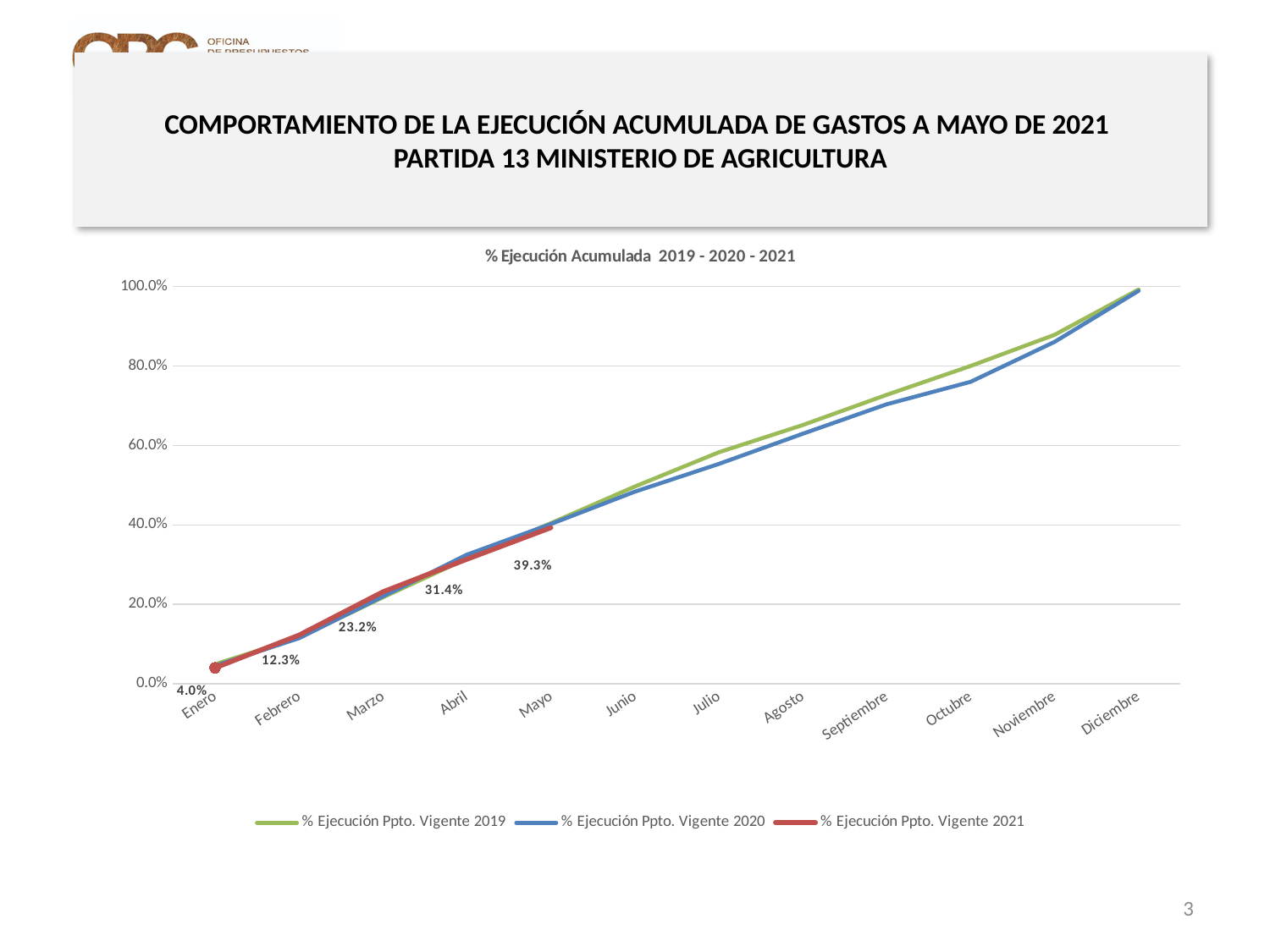
What is the title of the chart? % Ejecución Acumulada 2019 - 2020 - 2021 What is the value for Marzo in the % Ejecución Ppto. Vigente 2021 series? 23.2% Is the value for Octubre in the % Ejecución Ppto. Vigente 2020 series greater or less than 80.0%? less What is the value for Enero in the % Ejecución Ppto. Vigente 2021 series? 4.0% Do the values rise or fall from Enero to Diciembre in the % Ejecución Ppto. Vigente 2020 series? rise What is the difference between the Mayo and Abril values in the % Ejecución Ppto. Vigente 2021 series? 7.9% How many series does the legend list? 3 Which month has the highest value in the % Ejecución Ppto. Vigente 2021 series? Mayo What kind of chart is shown on the slide? line chart What is the value for Mayo in the % Ejecución Ppto. Vigente 2021 series? 39.3% Which month has the lowest value in the % Ejecución Ppto. Vigente 2021 series? Enero How many months are shown along the x axis? 12